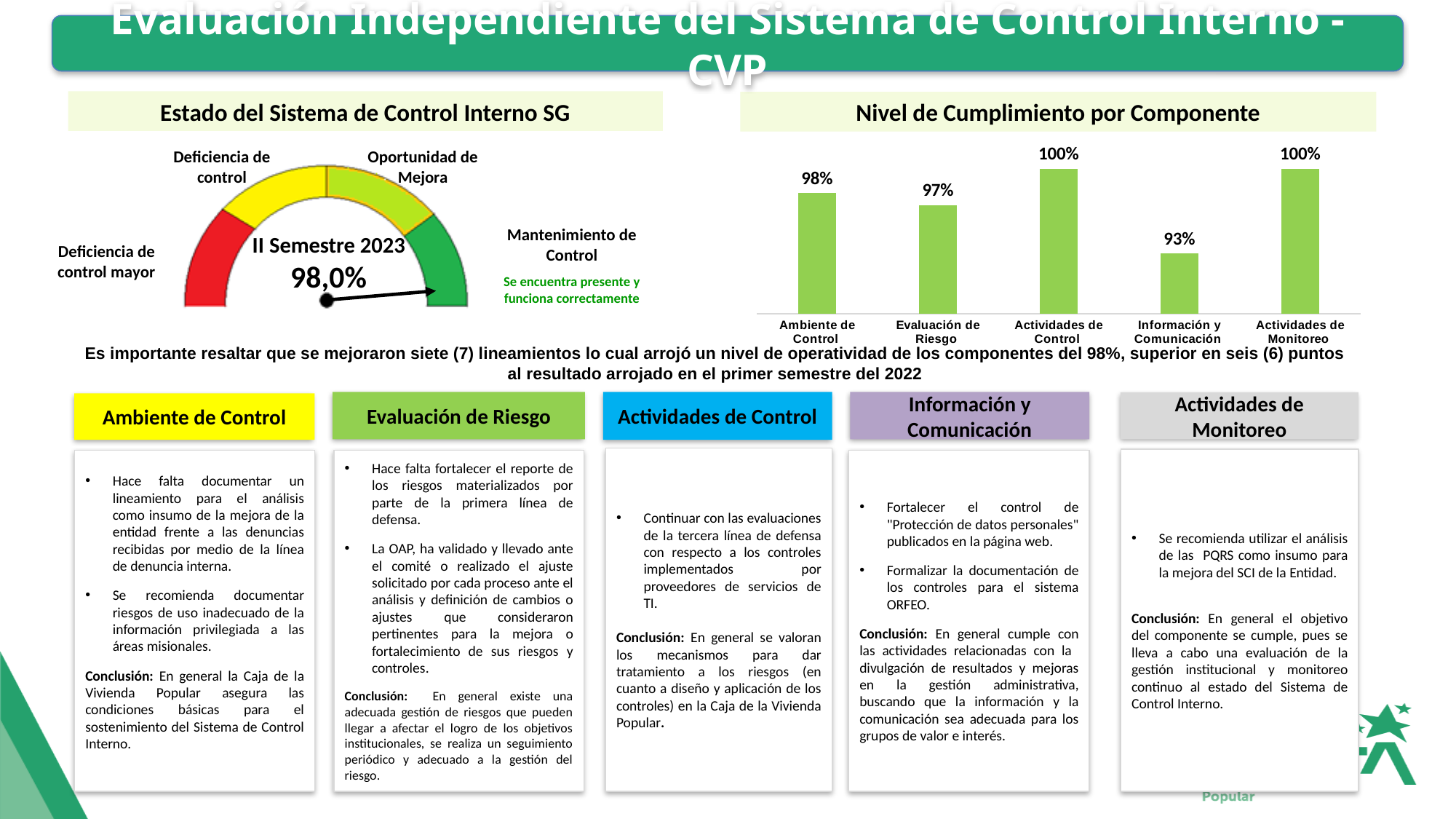
In the 'Nivel de Cumplimiento por Componente' bar chart, what is the value for Ambiente de Control? 98% In the 'Nivel de Cumplimiento por Componente' bar chart, what is the value for Información y Comunicación? 93% What kind of chart is 'Nivel de Cumplimiento por Componente'? Bar chart What value does the gauge chart under 'Estado del Sistema de Control Interno SG' show? 98,0% In the 'Nivel de Cumplimiento por Componente' bar chart, what is the difference between Actividades de Control and Información y Comunicación? 7 percentage points In the 'Nivel de Cumplimiento por Componente' bar chart, what is the value for Evaluación de Riesgo? 97% In the 'Nivel de Cumplimiento por Componente' bar chart, how many components reach 100%? 2 Which period is labelled on the gauge chart under 'Estado del Sistema de Control Interno SG'? II Semestre 2023 In the 'Nivel de Cumplimiento por Componente' bar chart, which component has the lowest value? Información y Comunicación How many components are shown in the 'Nivel de Cumplimiento por Componente' bar chart? 5 In the 'Nivel de Cumplimiento por Componente' bar chart, what is the value for Actividades de Monitoreo? 100% In the 'Nivel de Cumplimiento por Componente' bar chart, which is larger: Ambiente de Control or Evaluación de Riesgo? Ambiente de Control